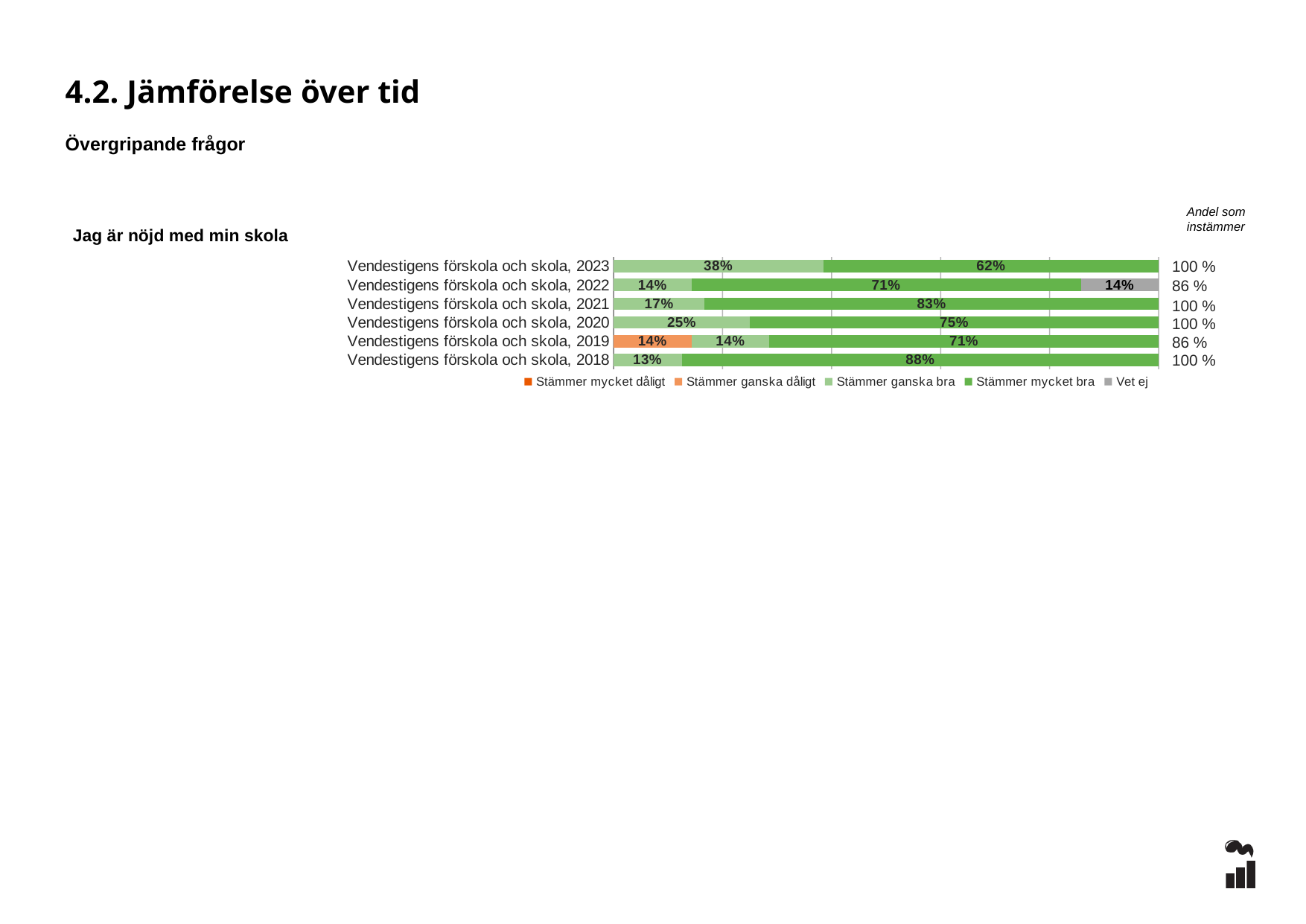
Which category has the lowest value for 'Stämmer mycket bra'? Vendestigens förskola och skola, 2023 What is the value for 'Stämmer mycket bra' for Vendestigens förskola och skola, 2023? 62% What is the value for 'Stämmer ganska dåligt' for Vendestigens förskola och skola, 2019? 14% How many categories (bars) does the chart show? 6 What is the value for 'Vet ej' for Vendestigens förskola och skola, 2022? 14% Which category has the highest value for 'Stämmer mycket bra'? Vendestigens förskola och skola, 2018 What is the value for 'Stämmer ganska bra' for Vendestigens förskola och skola, 2020? 25% What is the difference between the 'Stämmer mycket bra' values for 2021 and 2023? 21% How many series does the legend list? 5 Which is larger: the 'Stämmer ganska bra' value for 2023 or for 2021? 2023 What is the 'Andel som instämmer' value shown for Vendestigens förskola och skola, 2019? 86 % What kind of chart is shown on the slide? Stacked bar chart